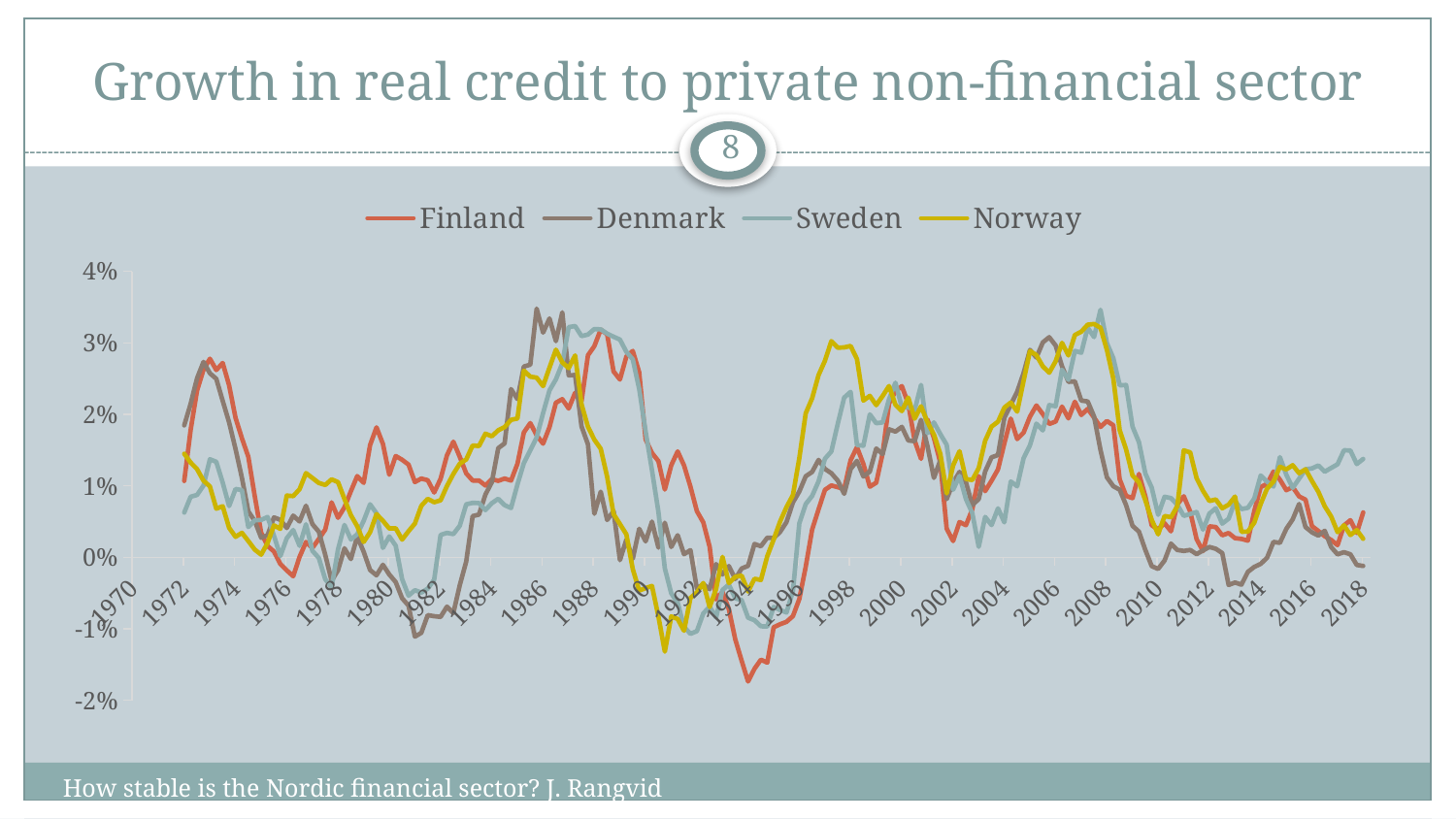
What kind of chart is shown on the slide? line chart Which line reaches the lowest value on the chart, around 1993: Finland or Norway? Finland Is the peak of the Norway line around 1997 greater or less than 2%? greater Is the value of the Sweden line at the end of the series in 2018 greater or less than 1%? greater Is the peak of the Sweden line around 2008 greater or less than 3%? greater How many series does the legend list? 4 What is the title of the chart? Growth in real credit to private non-financial sector What is the highest value shown on the vertical axis? 4% Which countries are listed in the chart legend? Finland, Denmark, Sweden, Norway